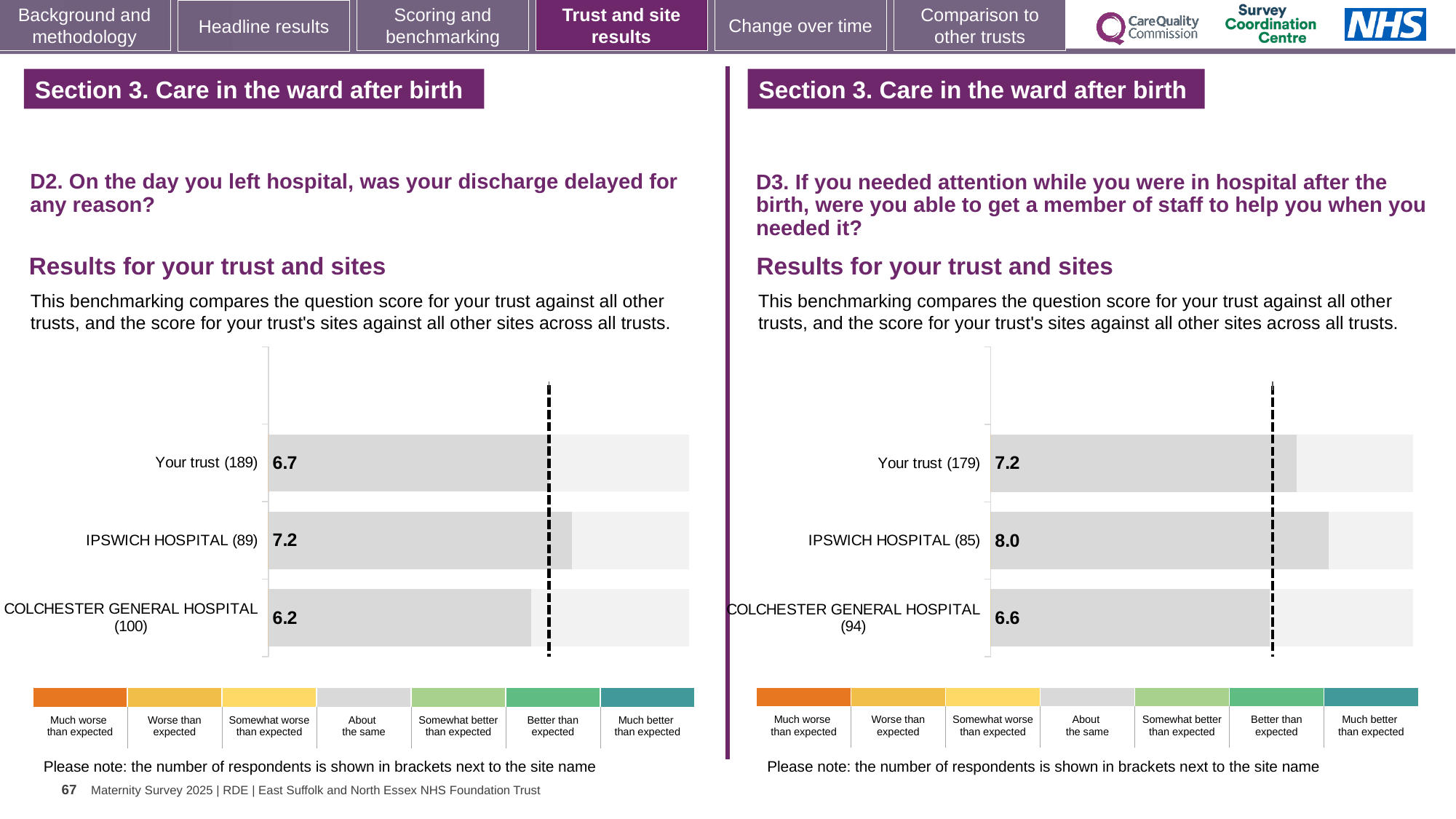
In the D2 chart on the left, which has the larger score, Your trust or IPSWICH HOSPITAL? IPSWICH HOSPITAL In the D3 chart on the right, what is the difference between the scores for IPSWICH HOSPITAL and COLCHESTER GENERAL HOSPITAL? 1.4 What kind of chart is used in the D2 chart on the left? Bar chart How many bars are plotted in the D3 chart on the right? 3 In the D2 chart on the left, what is the score for COLCHESTER GENERAL HOSPITAL? 6.2 In the D2 chart on the left, what is the score for Your trust? 6.7 In the D2 chart on the left, what is the score for IPSWICH HOSPITAL? 7.2 In the D2 chart on the left, how many respondents are shown in brackets for COLCHESTER GENERAL HOSPITAL? 100 In the D3 chart on the right, which site or trust has the highest score? IPSWICH HOSPITAL In the D2 chart on the left, which site or trust has the lowest score? COLCHESTER GENERAL HOSPITAL In the D3 chart on the right, what is the score for IPSWICH HOSPITAL? 8.0 In the D3 chart on the right, what is the score for COLCHESTER GENERAL HOSPITAL? 6.6